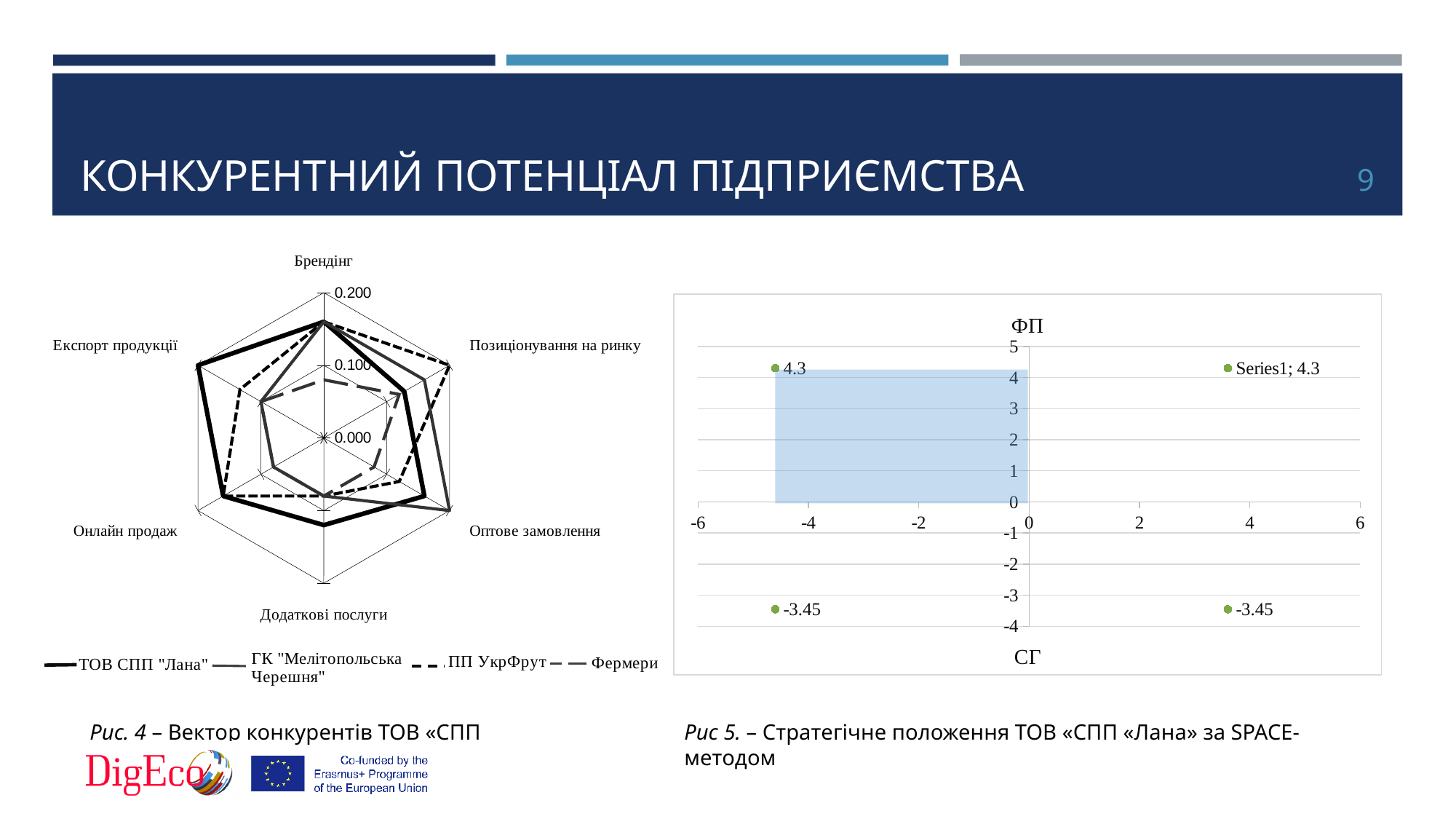
On the right scatter chart, what value is labelled on the two points below the horizontal axis? -3.45 How many data points are plotted on the right scatter chart? 4 On the right scatter chart, what value is labelled on the point marked Series1? 4.3 What are the axis titles of the right scatter chart (vertical and horizontal)? ФП and СГ What kind of chart is the right chart (Рис 5)? scatter chart In the left radar chart, is the value of ТОВ СПП "Лана" for Брендінг greater or less than 0.100? greater What kind of chart is the left chart (Рис. 4)? radar chart What is the maximum value shown on the radial axis of the left radar chart? 0.200 How many series does the legend of the left radar chart list? 4 In the left radar chart, is the value of ТОВ СПП "Лана" for Експорт продукції greater or less than 0.100? greater How many categories (axes) does the radar chart on the left have? 6